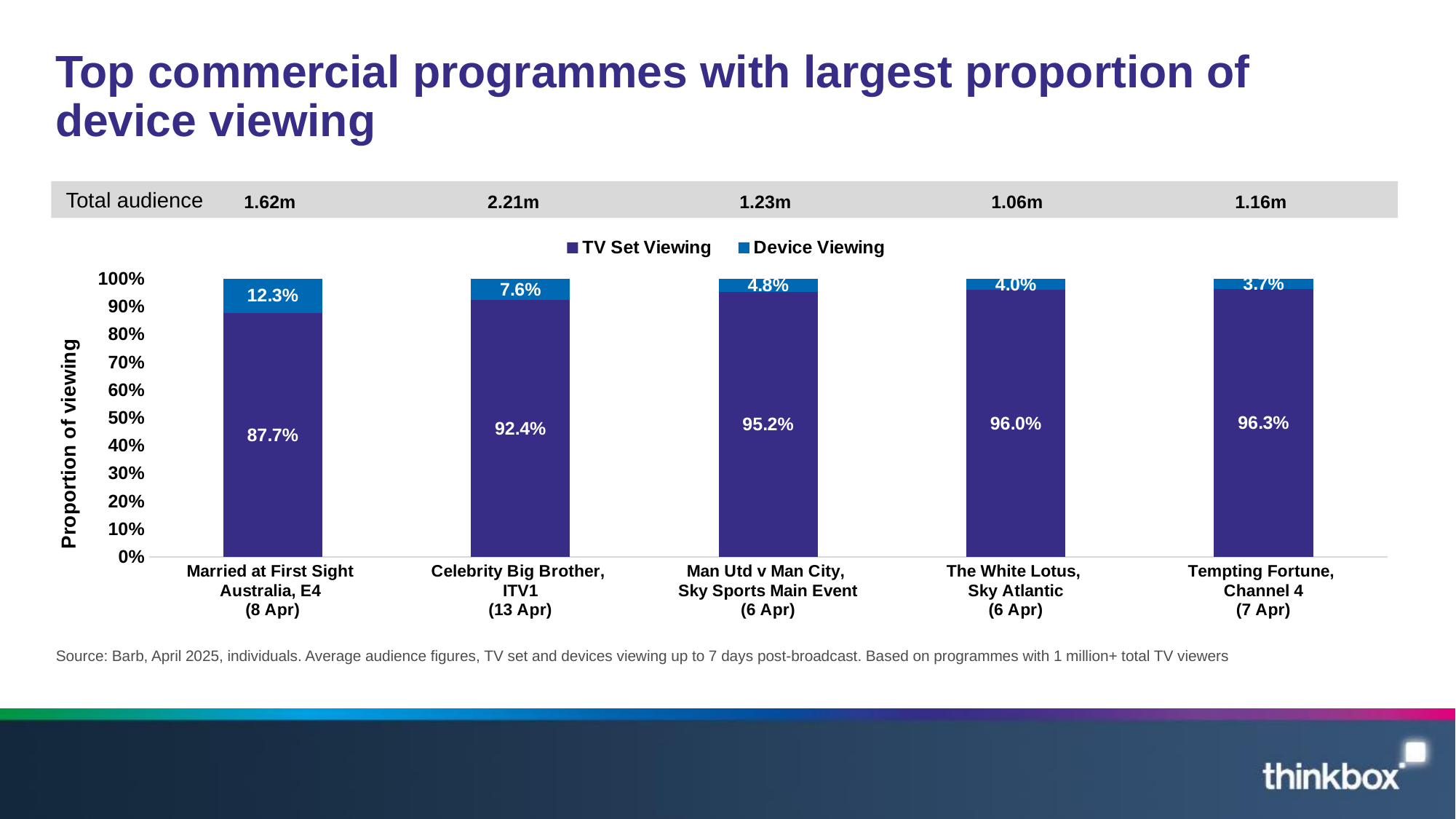
Which has a larger TV Set Viewing share: Man Utd v Man City or Celebrity Big Brother? Man Utd v Man City Does the Device Viewing share rise or fall from left to right across the programmes? Fall What is the Device Viewing share for Married at First Sight Australia, E4 (8 Apr)? 12.3% How many series does the legend list? 2 What is the Device Viewing share for The White Lotus, Sky Atlantic (6 Apr)? 4.0% What kind of chart is shown on the slide? Stacked bar chart What is the total audience shown for Celebrity Big Brother, ITV1? 2.21m Which programme has the lowest Device Viewing share? Tempting Fortune, Channel 4 (7 Apr) What is the TV Set Viewing share for Celebrity Big Brother, ITV1 (13 Apr)? 92.4% Which programme has the highest Device Viewing share? Married at First Sight Australia, E4 (8 Apr) What is the difference in Device Viewing share between Married at First Sight Australia and Celebrity Big Brother? 4.7% How many programmes are shown in the chart? 5